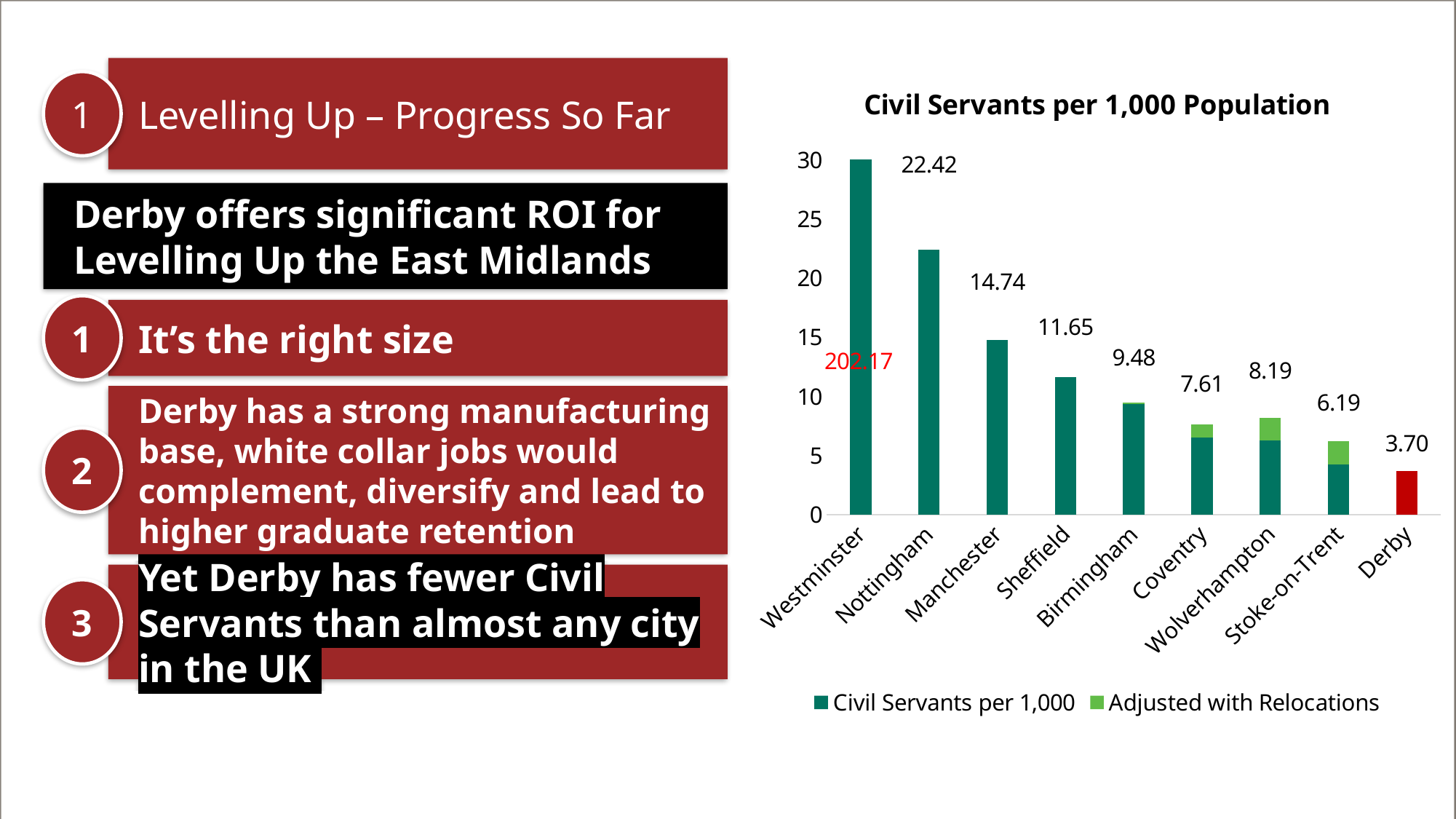
What kind of chart is shown on the slide? bar chart What is the value shown for Nottingham in the chart? 22.42 What is the value shown for Manchester in the chart? 14.74 Is the value for Birmingham greater or less than 10? less Which has a larger value, Sheffield or Birmingham? Sheffield What is the difference between the values for Nottingham and Manchester? 7.68 Which city has the highest value in the chart? Westminster How many series does the chart legend list? 2 What is the value shown for Sheffield in the chart? 11.65 Which city has the lowest value in the chart? Derby How many cities are shown on the x axis of the chart? 9 What is the value shown for Derby in the Civil Servants per 1,000 Population chart? 3.70